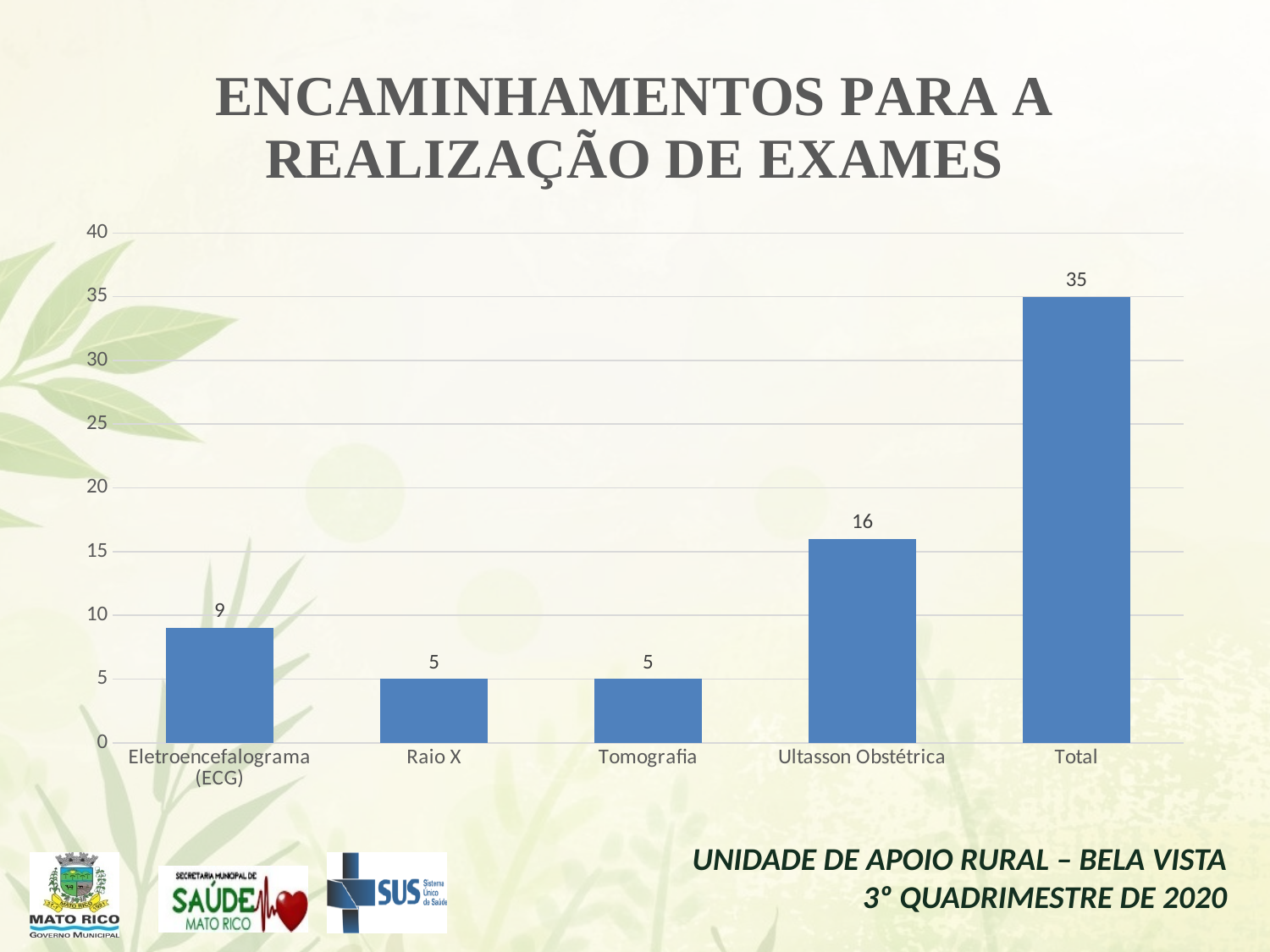
What is the title of the chart? ENCAMINHAMENTOS PARA A REALIZAÇÃO DE EXAMES How many categories are shown on the x axis? 5 Which is larger, the value for Eletroencefalograma (ECG) or the value for Tomografia? Eletroencefalograma (ECG) What is the value for Ultasson Obstétrica? 16 What is the difference between the values for Ultasson Obstétrica and Eletroencefalograma (ECG)? 7 What is the value for Eletroencefalograma (ECG)? 9 What is the value for Total? 35 What kind of chart is shown on the slide? bar chart Excluding the Total bar, which category has the highest value? Ultasson Obstétrica Which category has the highest bar overall? Total What is the value for Raio X? 5 Is the value for Ultasson Obstétrica greater or less than 20? less